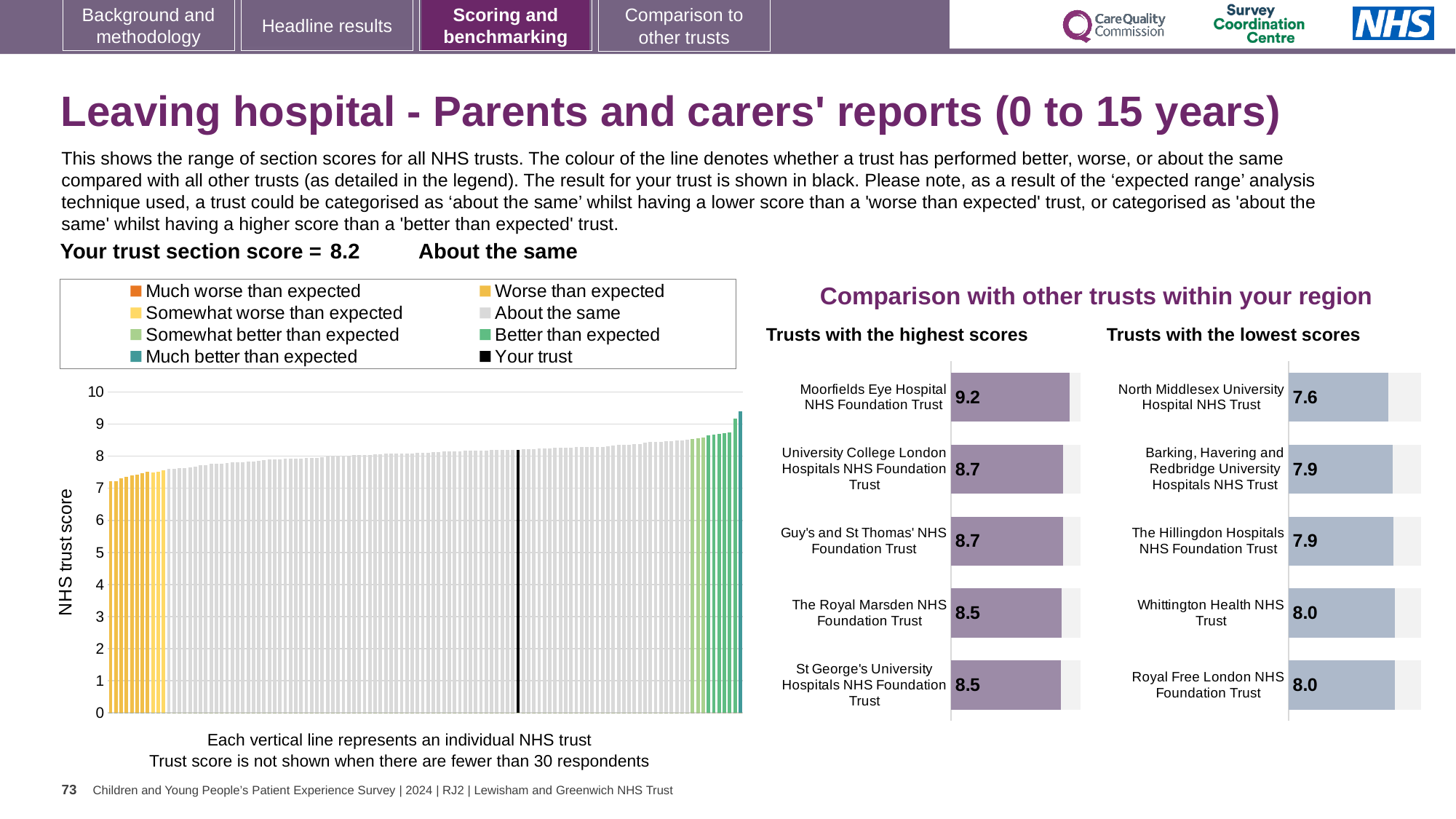
In the 'Trusts with the lowest scores' chart, which has the larger score: Whittington Health NHS Trust or The Hillingdon Hospitals NHS Foundation Trust? Whittington Health NHS Trust How many entries does the legend of the main chart on the left list? 8 In the 'Trusts with the highest scores' chart, what is the difference between the scores of Moorfields Eye Hospital NHS Foundation Trust and The Royal Marsden NHS Foundation Trust? 0.7 In the 'Trusts with the highest scores' chart, what is the score for The Royal Marsden NHS Foundation Trust? 8.5 In the 'Trusts with the highest scores' chart, what is the score for Moorfields Eye Hospital NHS Foundation Trust? 9.2 In the 'Trusts with the lowest scores' chart, which trust has the lowest score? North Middlesex University Hospital NHS Trust In the main chart on the left showing all NHS trusts, is the value of the leftmost bar greater or less than 8? less In the 'Trusts with the lowest scores' chart, what is the score for North Middlesex University Hospital NHS Trust? 7.6 In the 'Trusts with the highest scores' chart, which trust has the highest score? Moorfields Eye Hospital NHS Foundation Trust How many trusts are shown in the 'Trusts with the lowest scores' chart? 5 In the main chart on the left showing all NHS trusts, what is the section score for your trust (the black line)? 8.2 In the main chart on the left showing all NHS trusts, do the trust scores rise or fall from left to right? rise